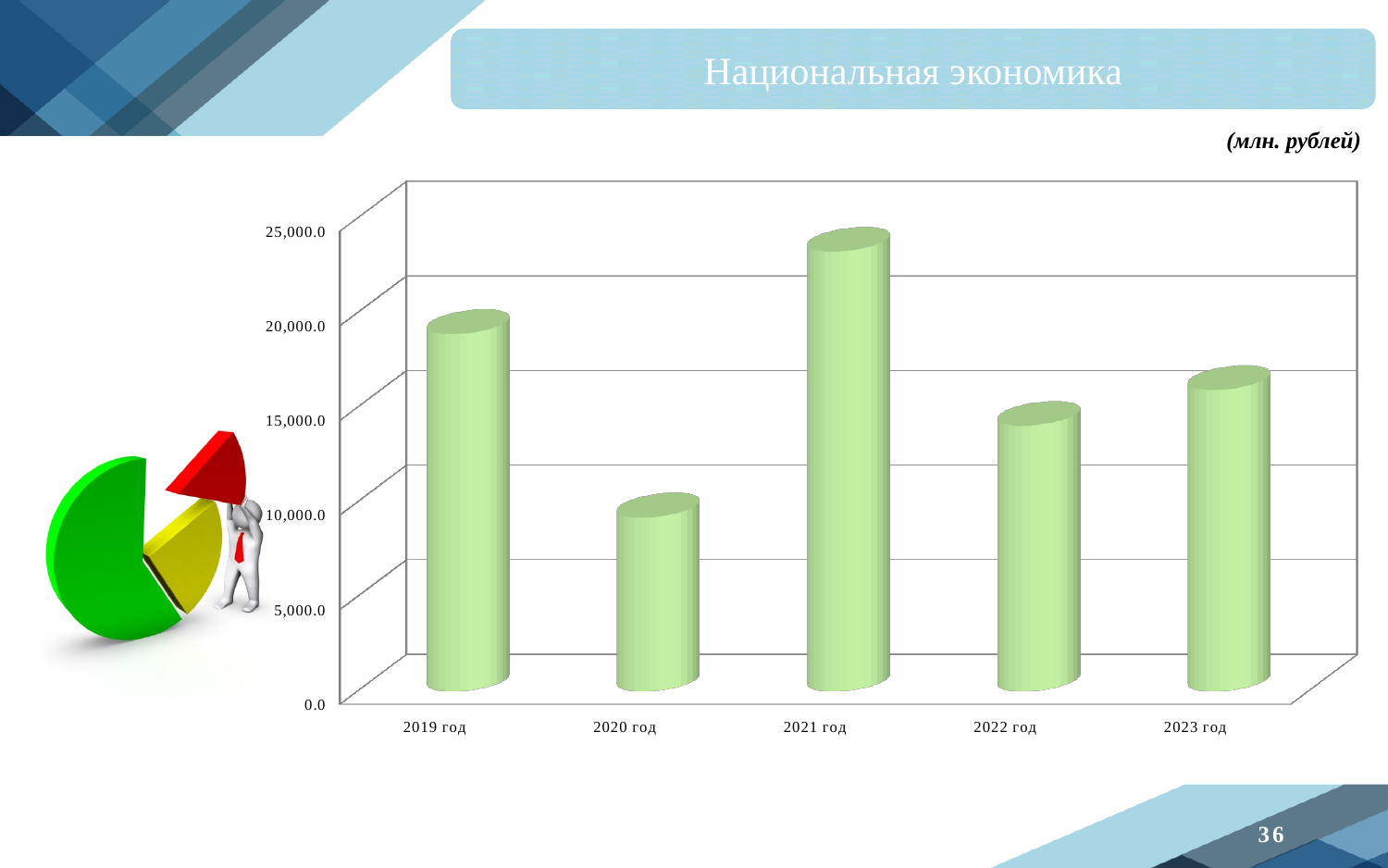
Is the value for 2023 год greater or less than 20,000.0? less Does the value rise or fall from 2019 год to 2020 год? fall Is the value for 2021 год greater or less than 20,000.0? greater Which year has the highest value on the chart? 2021 год Is the value for 2019 год greater or less than 15,000.0? greater What is the title of the chart on the slide? Национальная экономика Which year has the lowest value on the chart? 2020 год Which is larger, the value for 2019 год or the value for 2022 год? 2019 год How many years (categories) are plotted on the chart? 5 Which is larger, the value for 2023 год or the value for 2022 год? 2023 год What kind of chart is shown on the slide? bar chart